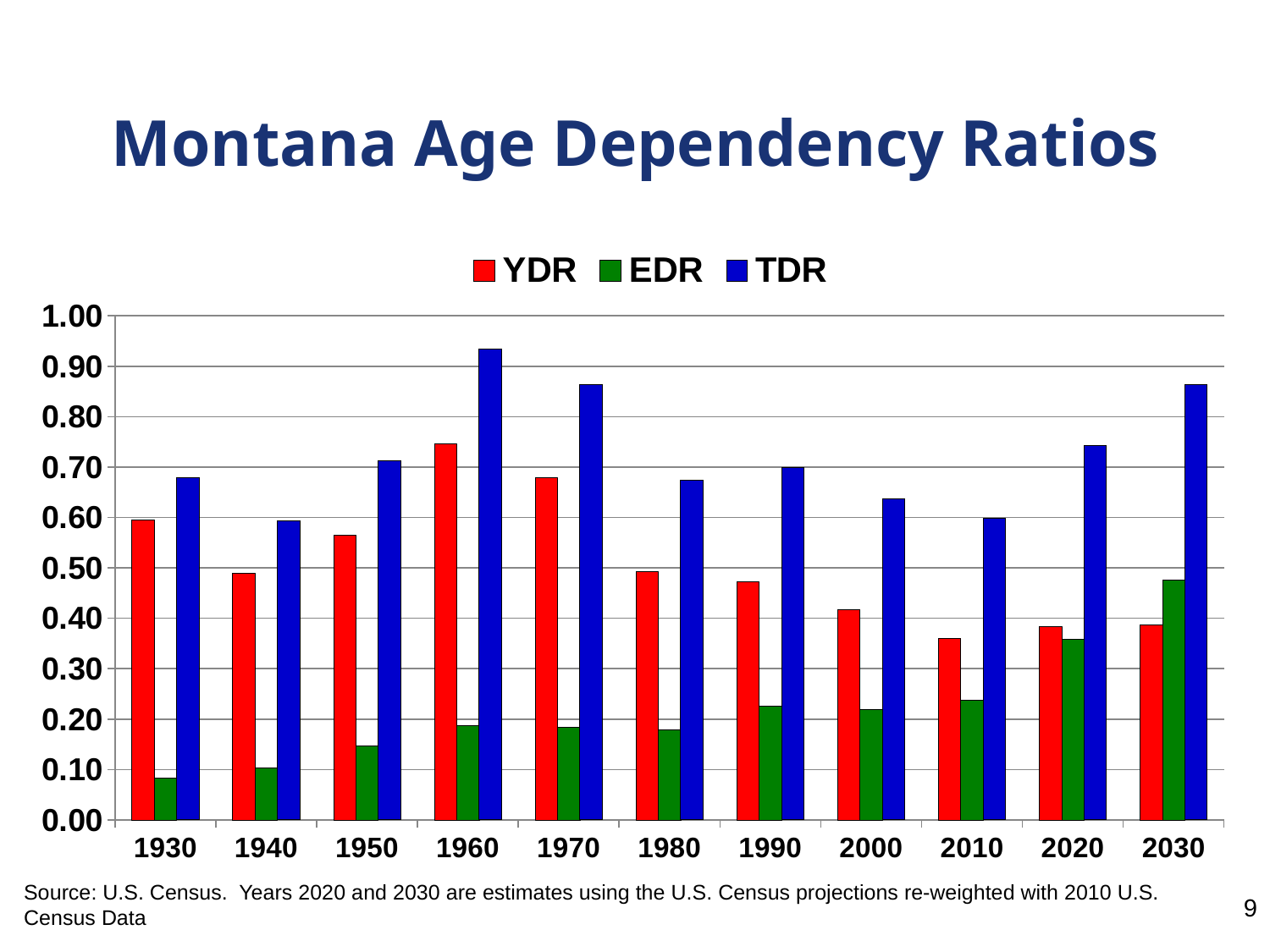
Does the EDR series generally rise or fall from 1930 to 2030? Rise How many series does the legend list? 3 Is the EDR value for 1930 greater or less than 0.10? less How many years are shown on the x axis? 11 In which year is the EDR value lowest? 1930 In which year is the TDR value highest? 1960 In which year is the EDR value highest? 2030 Is the TDR value for 1960 greater or less than 0.90? greater What colour are the TDR bars? Blue Is the YDR value for 1960 greater or less than 0.70? greater What kind of chart is shown on the slide? Bar chart In 2030, which is larger, YDR or EDR? EDR